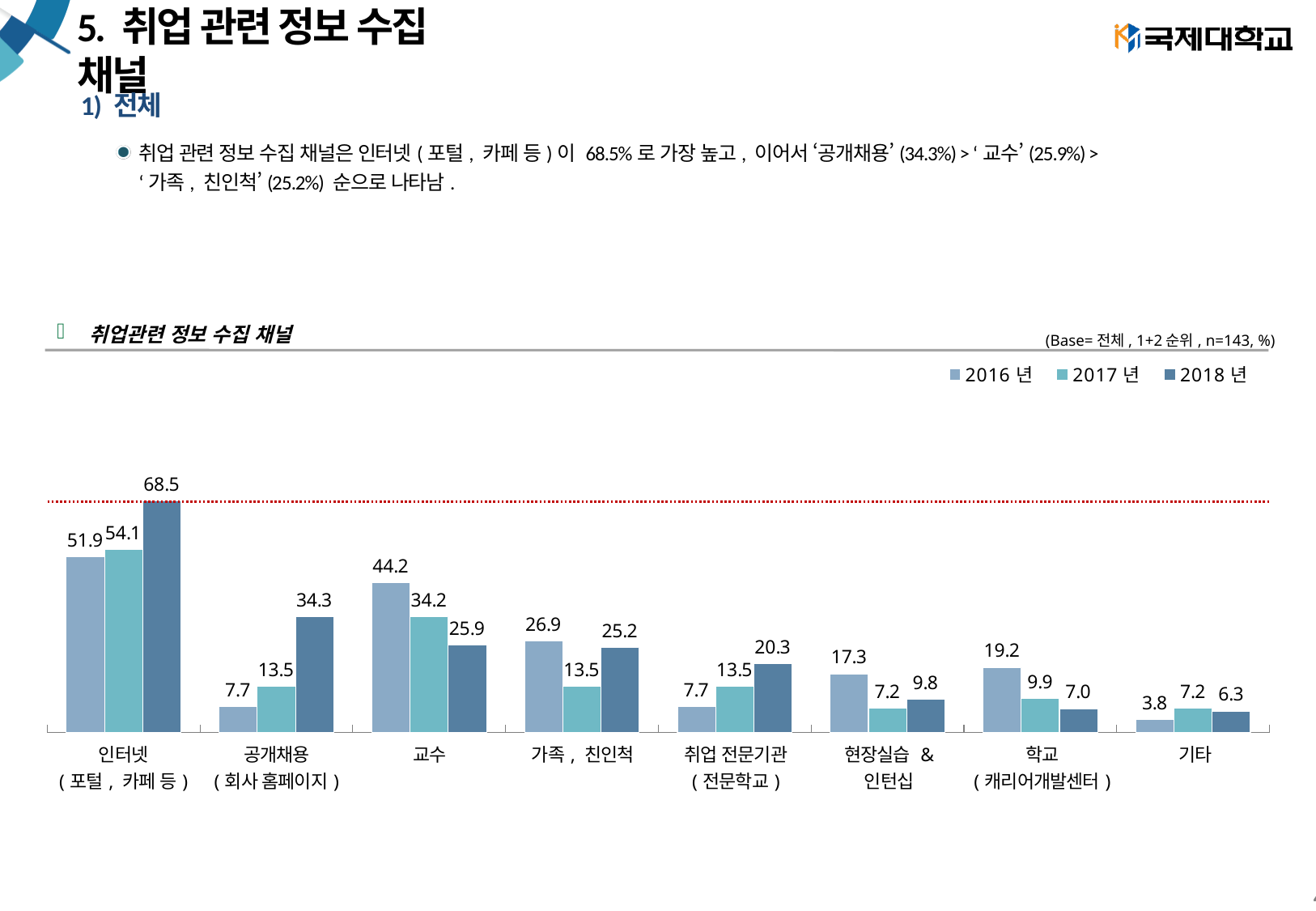
What kind of chart is shown on the slide? Bar chart What is the difference between the 2018 년 and 2016 년 values for 공개채용 (회사 홈페이지)? 26.6 What is the 2016 년 value for 교수? 44.2 Which category has the lowest 2016 년 value? 기타 Which is larger for 가족, 친인척: the 2016 년 value or the 2018 년 value? 2016 년 How many series does the legend list? 3 What is the title of the chart? 취업관련 정보 수집 채널 Do the values for 교수 rise or fall from 2016 년 to 2018 년? Fall Which category has the highest 2018 년 value? 인터넷 (포털, 카페 등) What is the 2017 년 value for 학교 (캐리어개발센터)? 9.9 How many categories are shown on the x axis? 8 What is the 2018 년 value for 인터넷 (포털, 카페 등)? 68.5